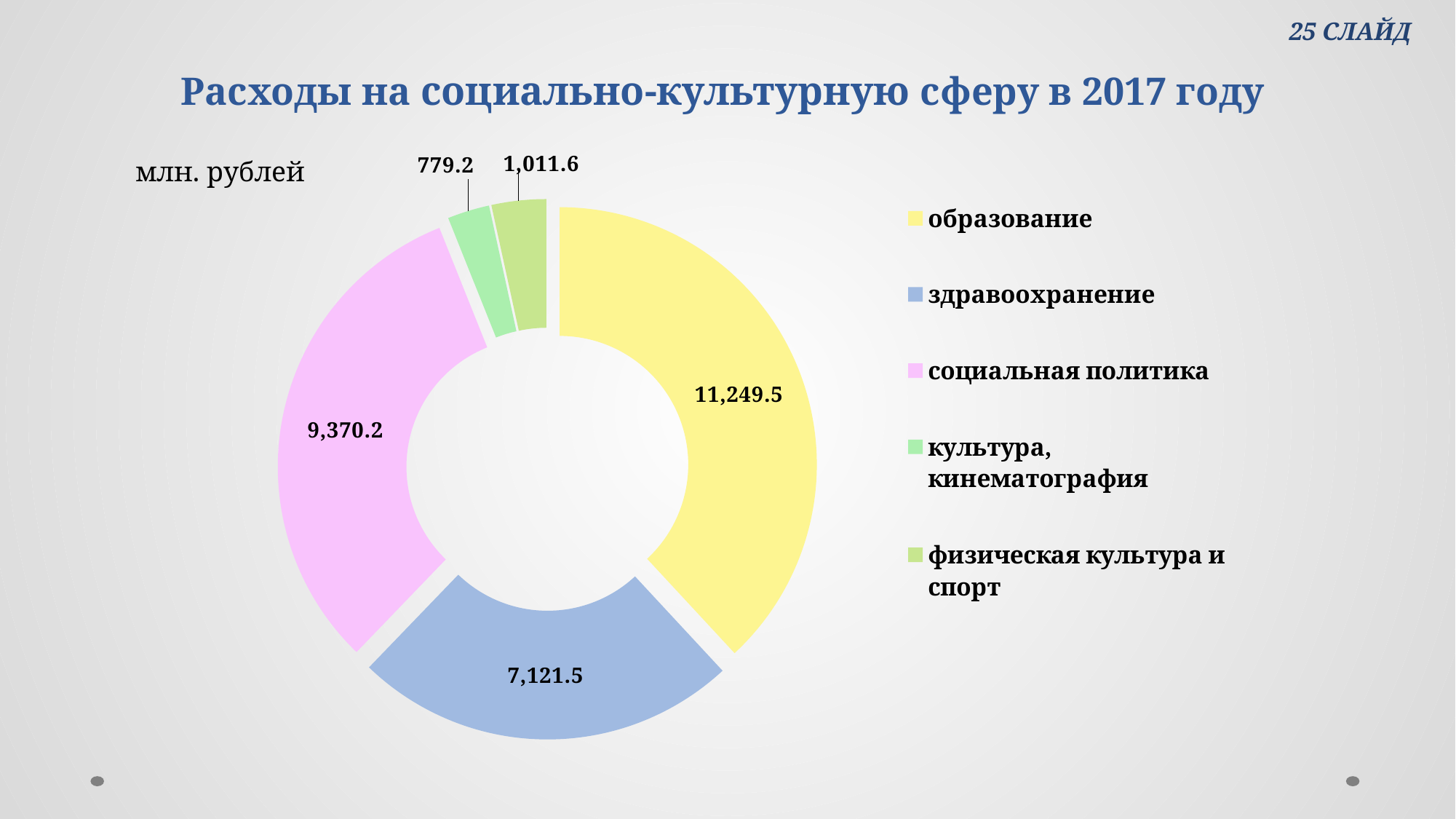
What kind of chart is shown on the slide? pie (doughnut) chart What is the value for здравоохранение? 7,121.5 How many categories does the chart show? 5 Which category has the lowest value? культура, кинематография What is the difference between the values for образование and социальная политика? 1,879.3 What is the value for физическая культура и спорт? 1,011.6 Which is larger: социальная политика or здравоохранение? социальная политика Which category has the highest value? образование What is the value for социальная политика? 9,370.2 What is the value for культура, кинематография? 779.2 What is the value for образование? 11,249.5 What unit is indicated for the values on the chart? млн. рублей